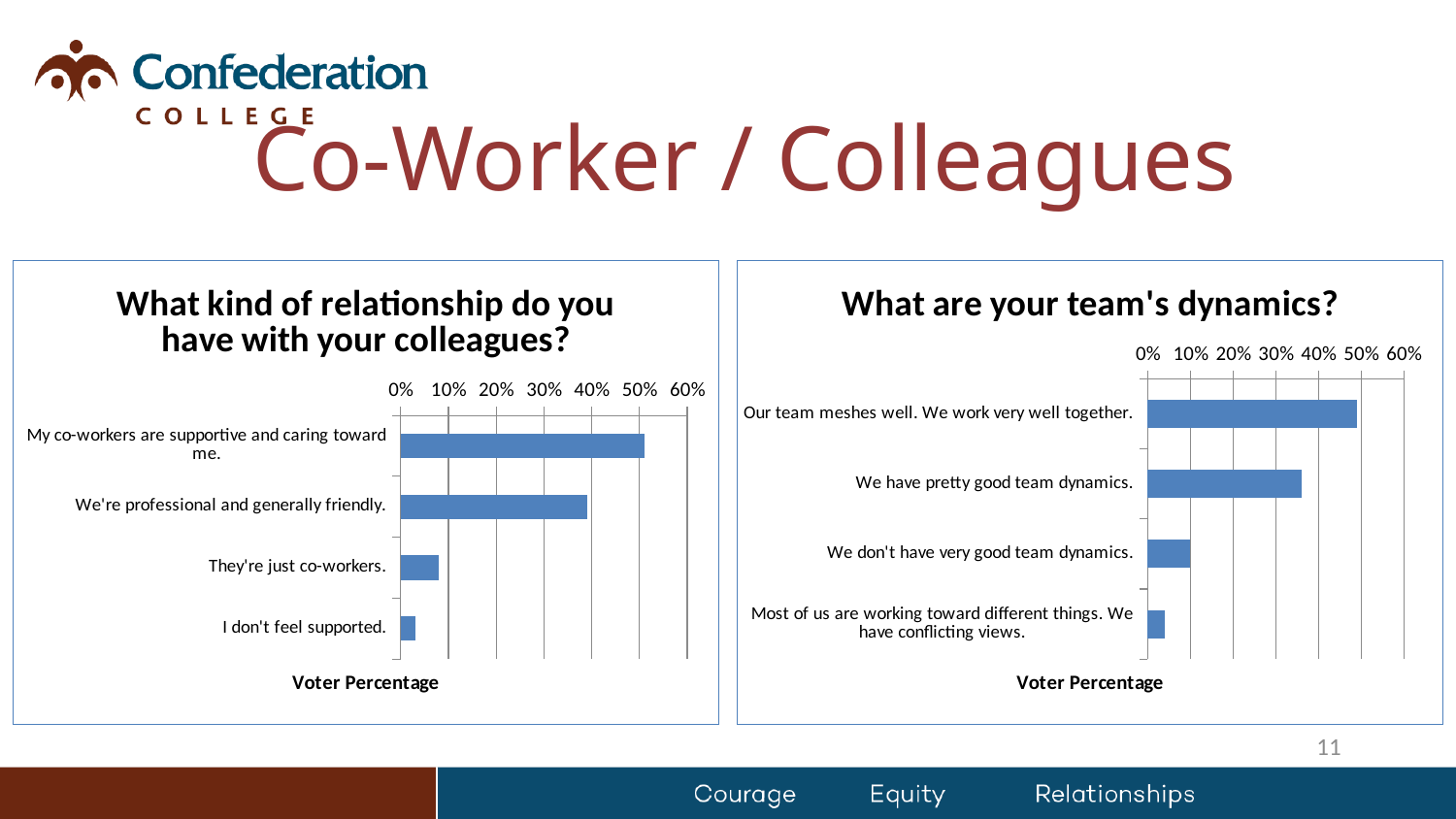
In the chart titled "What kind of relationship do you have with your colleagues?", which category has the lowest voter percentage? I don't feel supported. In the chart titled "What kind of relationship do you have with your colleagues?", is the value for "They're just co-workers." greater or less than 20%? less In the chart titled "What are your team's dynamics?", is the value for "We don't have very good team dynamics." greater or less than 20%? less In the chart titled "What kind of relationship do you have with your colleagues?", which is larger: "We're professional and generally friendly." or "They're just co-workers."? We're professional and generally friendly. In the chart titled "What are your team's dynamics?", which category has the highest voter percentage? Our team meshes well. We work very well together. What kind of chart is the chart titled "What are your team's dynamics?"? bar chart In the chart titled "What kind of relationship do you have with your colleagues?", which category has the highest voter percentage? My co-workers are supportive and caring toward me. In the chart titled "What are your team's dynamics?", is the value for "Our team meshes well. We work very well together." greater or less than 40%? greater What is the x-axis title of the chart titled "What are your team's dynamics?"? Voter Percentage In the chart titled "What kind of relationship do you have with your colleagues?", how many categories are plotted? 4 In the chart titled "What are your team's dynamics?", which category has the lowest voter percentage? Most of us are working toward different things. We have conflicting views.